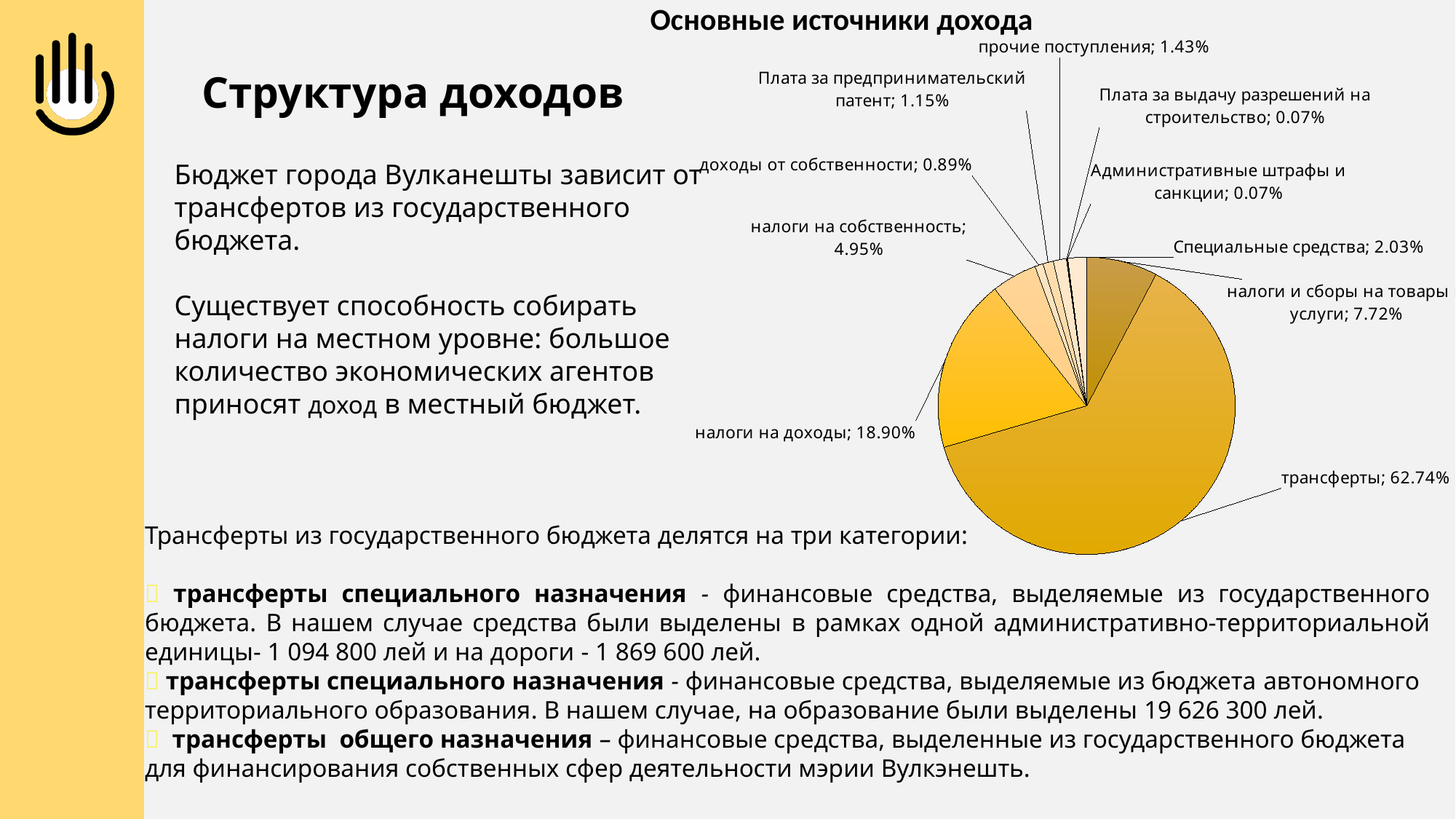
What share of the pie does "трансферты" represent? 62.74% What is the value shown for "Специальные средства"? 2.03% What is the value shown for "налоги на собственность"? 4.95% What type of chart is shown on the slide? pie chart Which is larger: the share for "налоги на собственность" or for "Специальные средства"? налоги на собственность What is the title of the chart? Основные источники дохода What is the value shown for "налоги на доходы"? 18.90% Which category has the largest share of the pie? трансферты What is the value shown for "прочие поступления"? 1.43% What is the value shown for "налоги и сборы на товары услуги"? 7.72% How many categories (slices) does the pie chart have? 10 What is the difference between the shares of "трансферты" and "налоги на доходы"? 43.84%